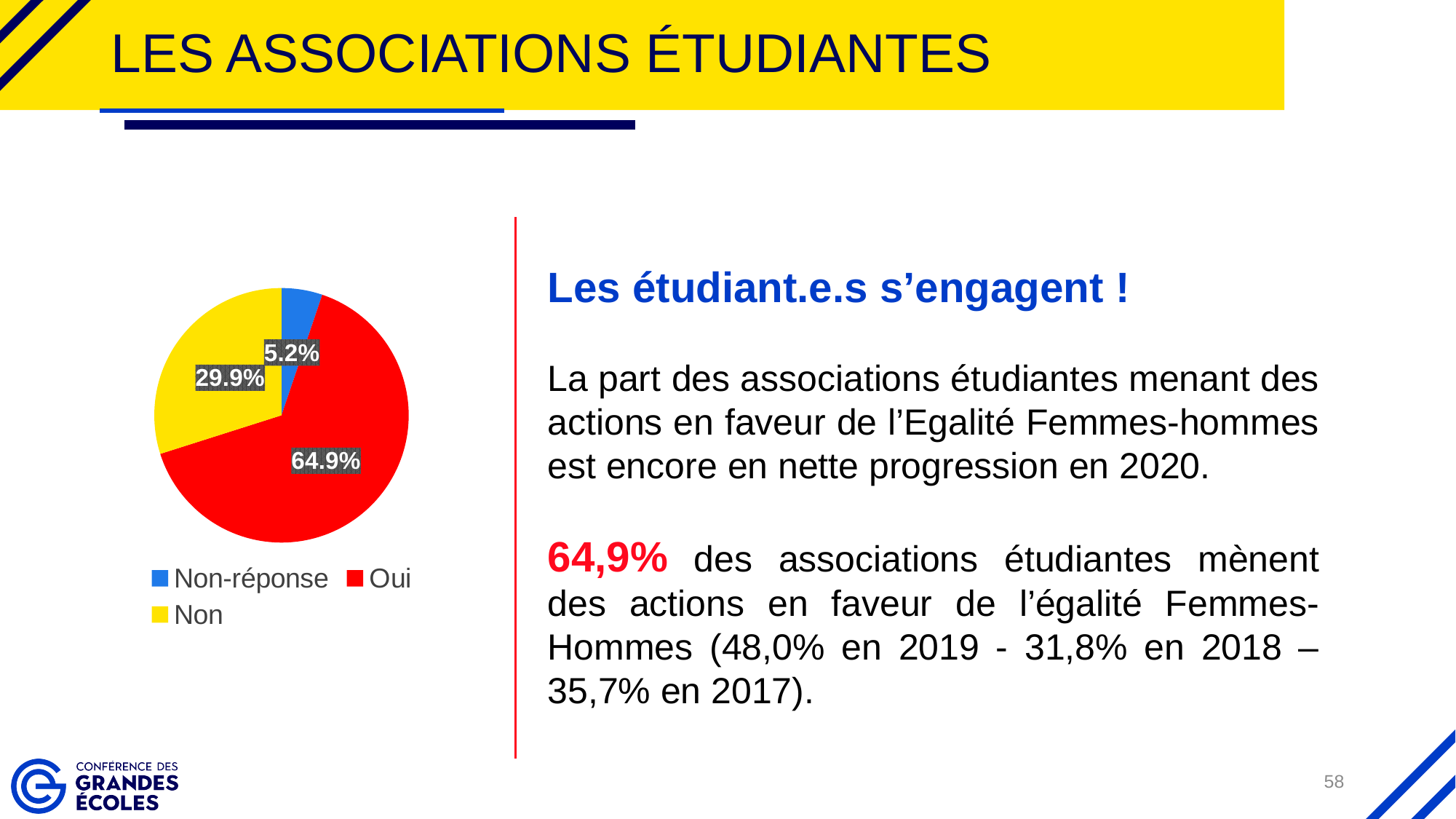
What is the difference in percentage points between the "Oui" and "Non" slices? 35.0 Which category has the smallest slice in the pie chart? Non-réponse What percentage of the pie chart is labelled "Non"? 29.9% Which slice is larger, "Non" or "Non-réponse"? Non What colour is the "Non" slice in the pie chart? yellow What is the combined share of the "Non" and "Non-réponse" slices? 35.1% What colour is the "Oui" slice in the pie chart? red What type of chart is shown on the slide? pie chart How many categories does the pie chart show? 3 What percentage of the pie chart is labelled "Oui"? 64.9% Which category has the largest slice in the pie chart? Oui What percentage of the pie chart is labelled "Non-réponse"? 5.2%